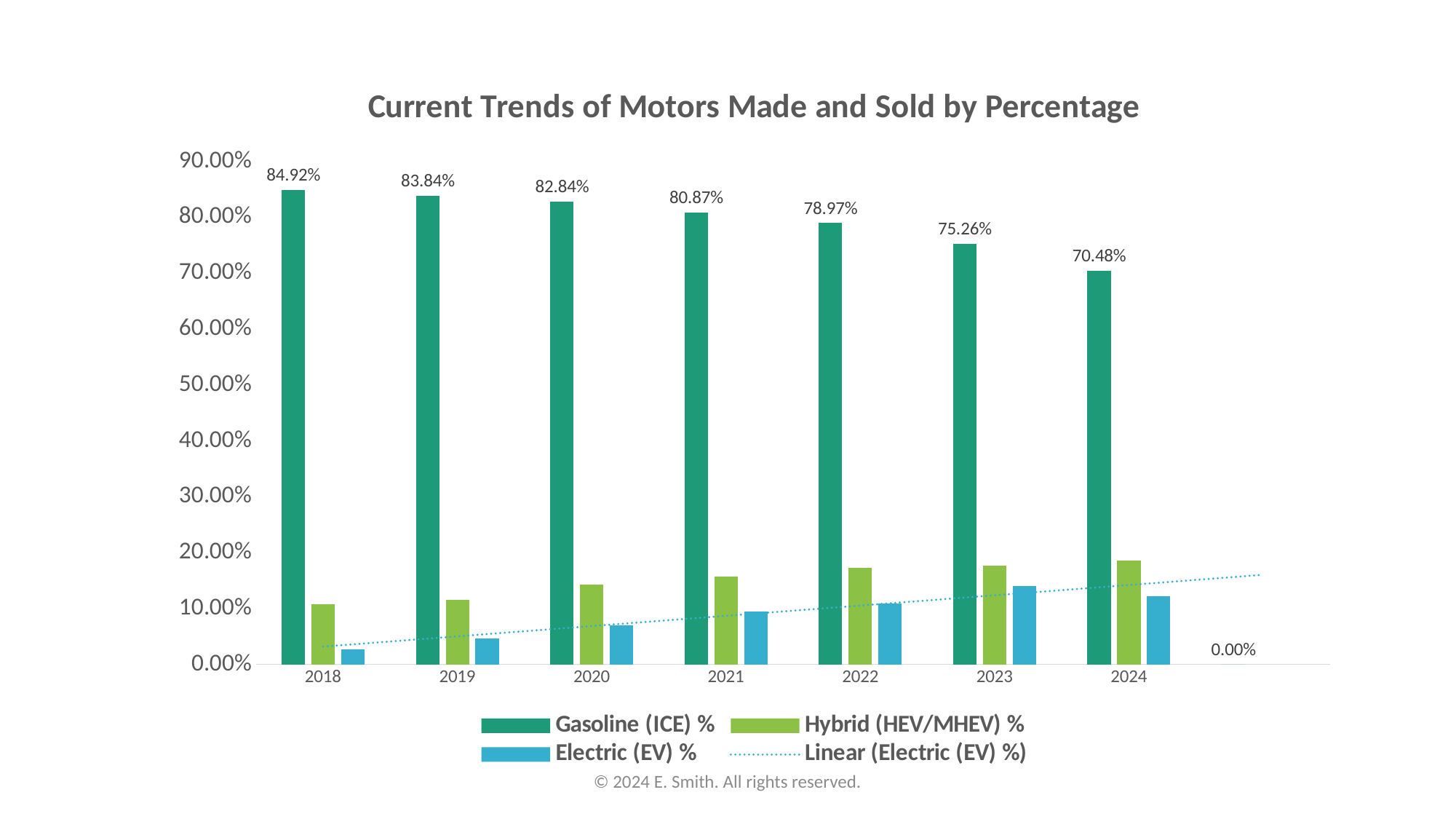
What is the Gasoline (ICE) % value for 2024? 70.48% Do the Gasoline (ICE) % values rise or fall from 2018 to 2024? Fall Is the Hybrid (HEV/MHEV) % value for 2024 greater or less than 10.00%? greater What is the Gasoline (ICE) % value for 2018? 84.92% What is the difference between the Gasoline (ICE) % values for 2018 and 2024? 14.44% Is the Electric (EV) % value for 2018 greater or less than 10.00%? less Which year has the highest Gasoline (ICE) % value? 2018 What kind of chart is shown on the slide? Bar chart What is the Gasoline (ICE) % value for 2021? 80.87% Which year has the lowest Gasoline (ICE) % value among the labelled years? 2024 How many series does the legend list? 4 Is the Gasoline (ICE) % value for 2022 larger than the value for 2023? Yes